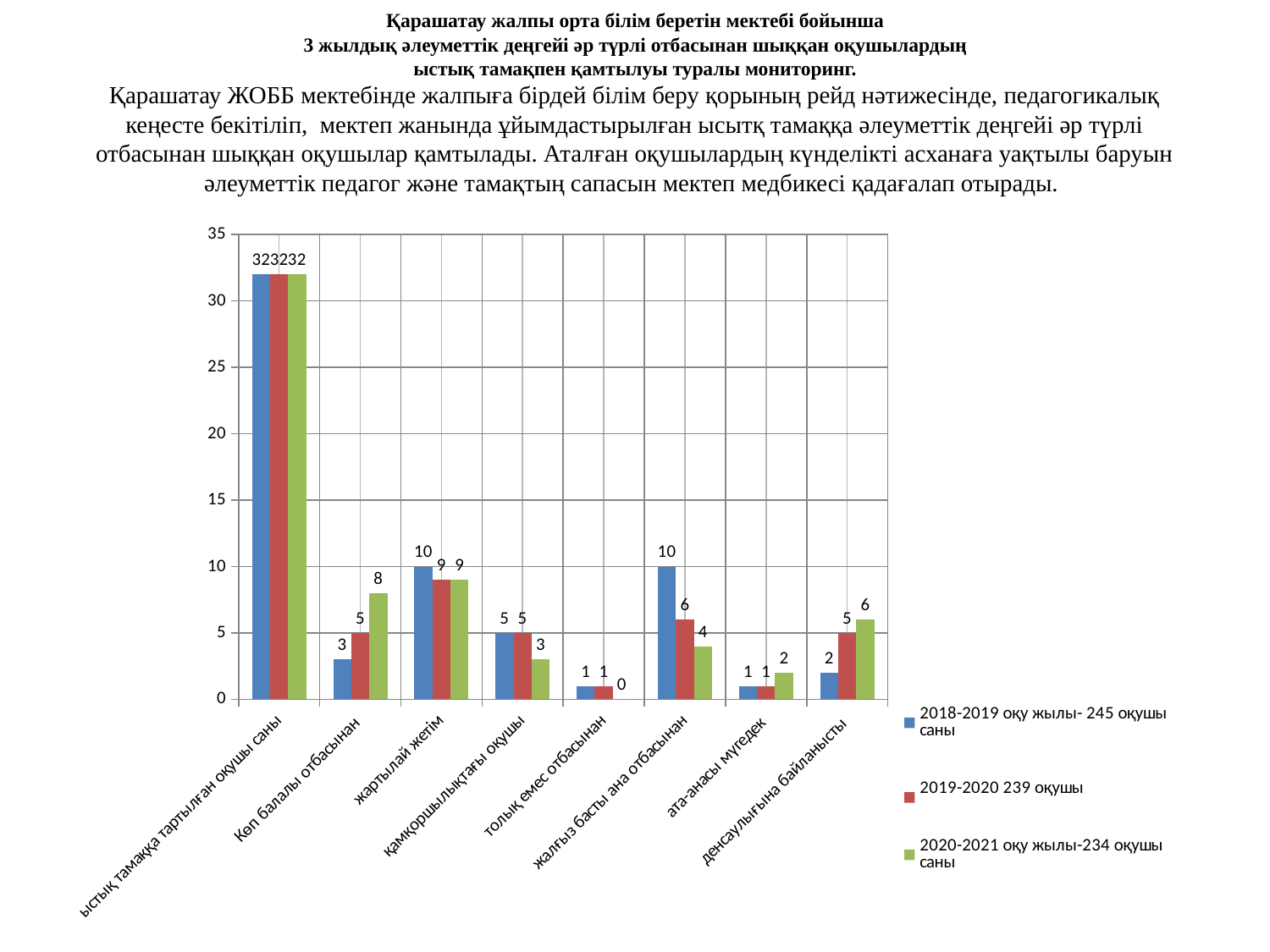
Which colour represents the 2019-2020 series in the legend? red Which category has the highest value in the 2018-2019 оқу жылы series? ыстық тамаққа тартылған оқушы саны For 'Көп балалы отбасынан', which series has the larger value: 2018-2019 оқу жылы or 2020-2021 оқу жылы? 2020-2021 оқу жылы What is the value for 'денсаулығына байланысты' in the 2019-2020 series? 5 What is the difference between the 2018-2019 and 2020-2021 values for 'жалғыз басты ана отбасынан'? 6 How many categories are shown on the x axis? 8 What is the value for 'жалғыз басты ана отбасынан' in the 2018-2019 оқу жылы series? 10 Which category has the lowest value in the 2020-2021 оқу жылы series? толық емес отбасынан How many series does the legend list? 3 What is the value for 'Көп балалы отбасынан' in the 2020-2021 оқу жылы series? 8 Is the value for 'ыстық тамаққа тартылған оқушы саны' in the 2019-2020 series greater or less than 30? greater What type of chart is shown on the slide? bar chart